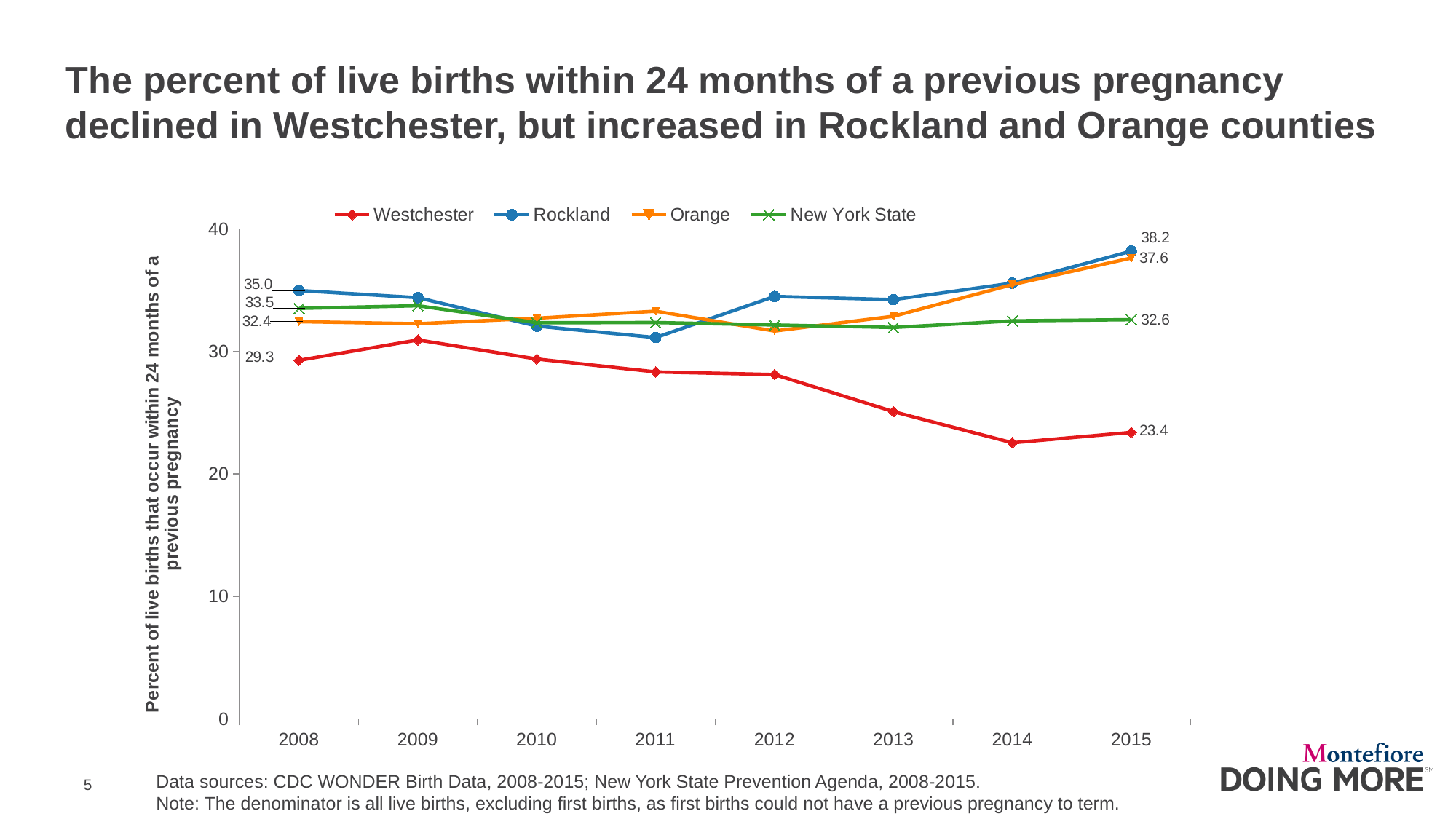
How many series does the legend list? 4 Is the value for Westchester in 2014 greater or less than 30? less What type of chart is shown on the slide? line chart By how much did the Westchester value change from 2008 to 2015? 5.9 Which series had the lowest value in 2008? Westchester How many years are shown on the x axis? 8 What was the value for Rockland in 2015? 38.2 What was the value for New York State in 2008? 33.5 Does the Westchester line rise or fall from 2008 to 2015? fall Which series had the highest value in 2015? Rockland What was the value for Orange in 2015? 37.6 What was the value for Westchester in 2008? 29.3